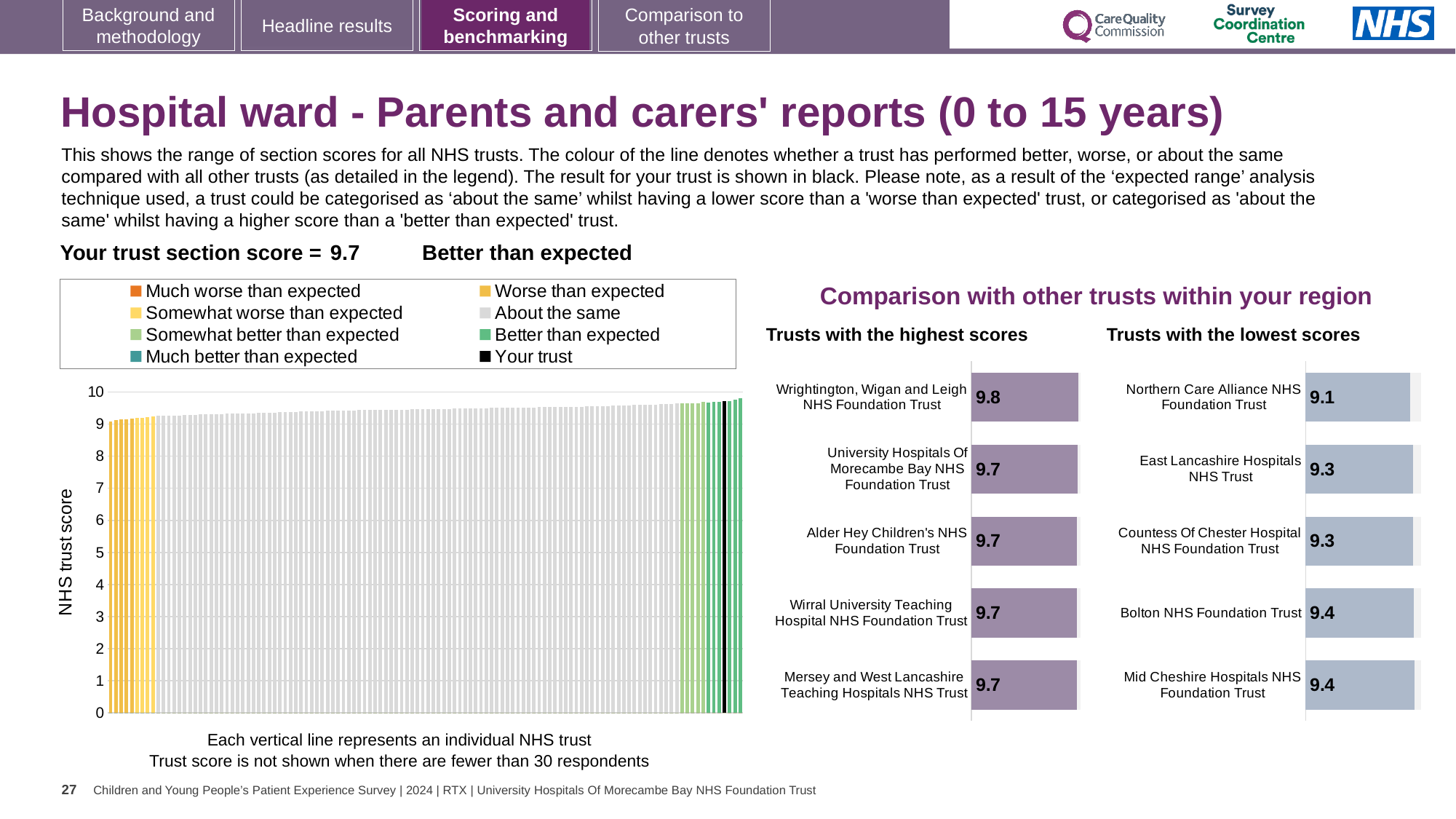
In the 'Trusts with the lowest scores' chart, what is the difference between the scores of Bolton NHS Foundation Trust and Northern Care Alliance NHS Foundation Trust? 0.3 In the 'Trusts with the lowest scores' chart, what is the score for Northern Care Alliance NHS Foundation Trust? 9.1 In the 'Trusts with the lowest scores' chart, what is the score for Bolton NHS Foundation Trust? 9.4 In the 'Trusts with the lowest scores' chart, which trust has the lowest score? Northern Care Alliance NHS Foundation Trust What is the y-axis title of the large chart on the left? NHS trust score In the 'Trusts with the lowest scores' chart, which has the higher score: East Lancashire Hospitals NHS Trust or Bolton NHS Foundation Trust? Bolton NHS Foundation Trust In the 'Trusts with the highest scores' chart, which trust has the highest score? Wrightington, Wigan and Leigh NHS Foundation Trust In the 'Trusts with the highest scores' chart, what is the score for Wrightington, Wigan and Leigh NHS Foundation Trust? 9.8 What kind of chart is the large chart on the left showing NHS trust scores? Bar chart How many trusts are shown in the 'Trusts with the lowest scores' chart? 5 How many trusts are shown in the 'Trusts with the highest scores' chart? 5 How many entries does the legend above the left-hand chart list? 8